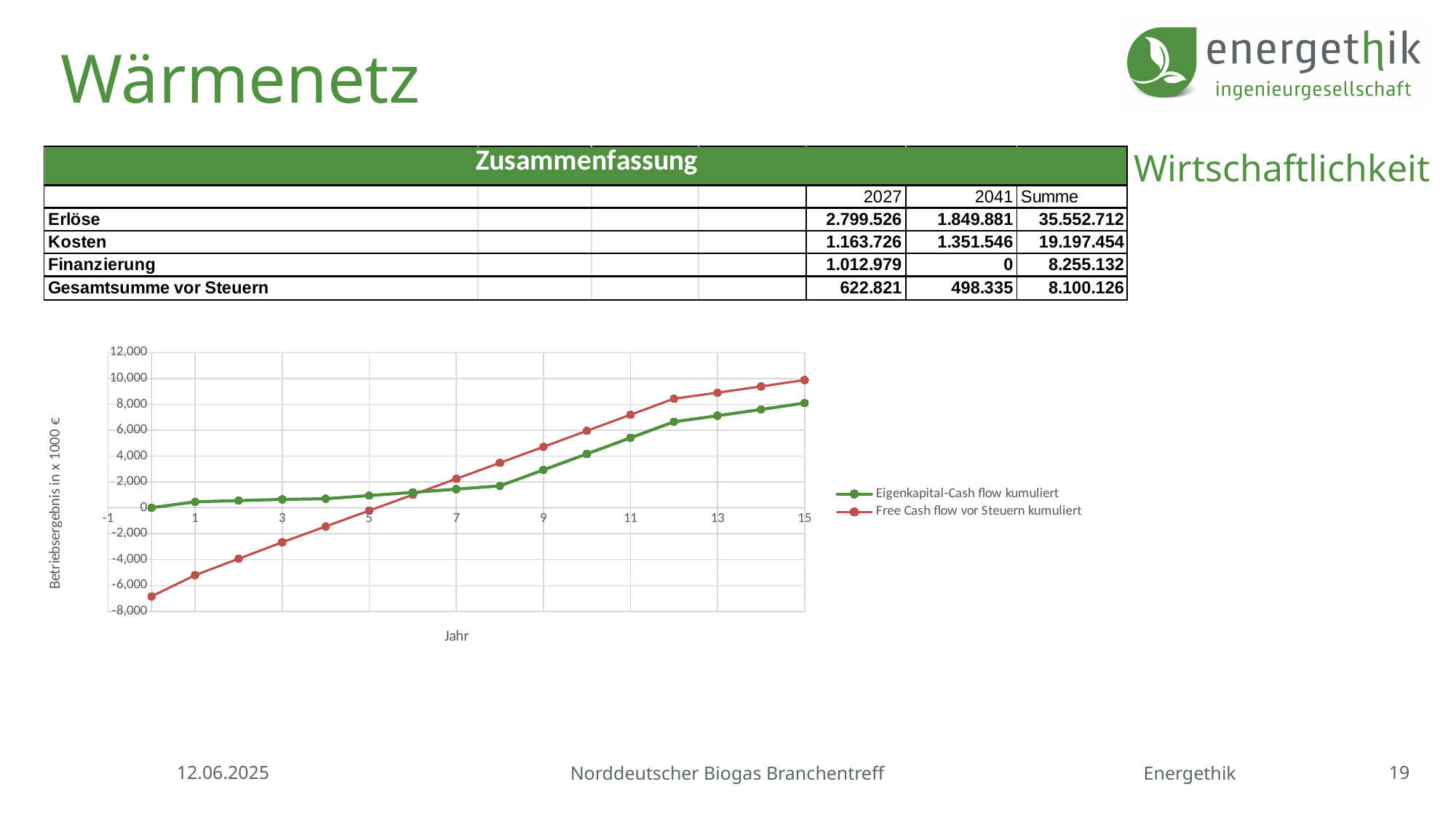
Is the value of Free Cash flow vor Steuern kumuliert at year 0 greater or less than -6,000? less What kind of chart is shown on the slide? line chart At year 2, which series has the higher value: Eigenkapital-Cash flow kumuliert or Free Cash flow vor Steuern kumuliert? Eigenkapital-Cash flow kumuliert At year 15, which series has the higher value: Eigenkapital-Cash flow kumuliert or Free Cash flow vor Steuern kumuliert? Free Cash flow vor Steuern kumuliert Is the value of Free Cash flow vor Steuern kumuliert at year 15 greater or less than 8,000? greater Do the values of the Eigenkapital-Cash flow kumuliert series rise or fall from year 0 to year 15? rise Do the values of the Free Cash flow vor Steuern kumuliert series rise or fall along the x axis? rise Which series is shown in red in the chart? Free Cash flow vor Steuern kumuliert What is the title of the vertical axis of the chart? Betriebsergebnis in x 1000 € How many series does the chart legend list? 2 Is the value of Eigenkapital-Cash flow kumuliert at year 11 greater or less than 4,000? greater